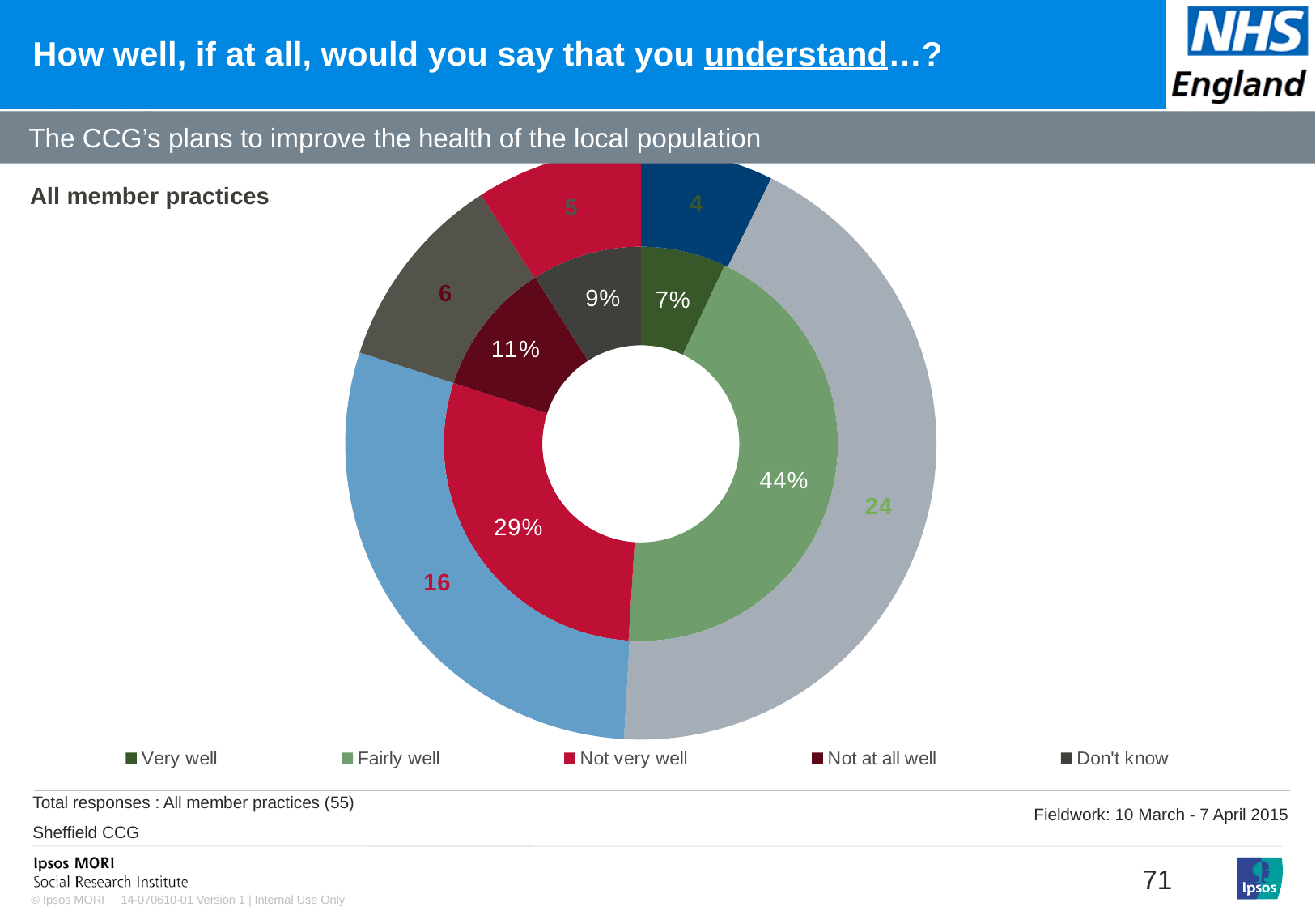
What percentage of respondents said they understand the CCG's plans 'Fairly well'? 44% What is the total of the counts shown in the outer ring of the chart? 55 Which response category has the largest share in the inner ring? Fairly well What type of chart is shown on the slide? Doughnut chart How many response categories does the legend list? 5 What percentage of respondents answered 'Don't know'? 9% Which response category has the smallest share in the inner ring? Very well What is the largest count shown in the outer ring of the chart? 24 Which is larger, the share for 'Not at all well' or the share for 'Don't know'? Not at all well What is the difference in percentage points between 'Fairly well' and 'Not very well'? 15 What percentage of respondents answered 'Not very well'? 29% What percentage of respondents answered 'Very well'? 7%